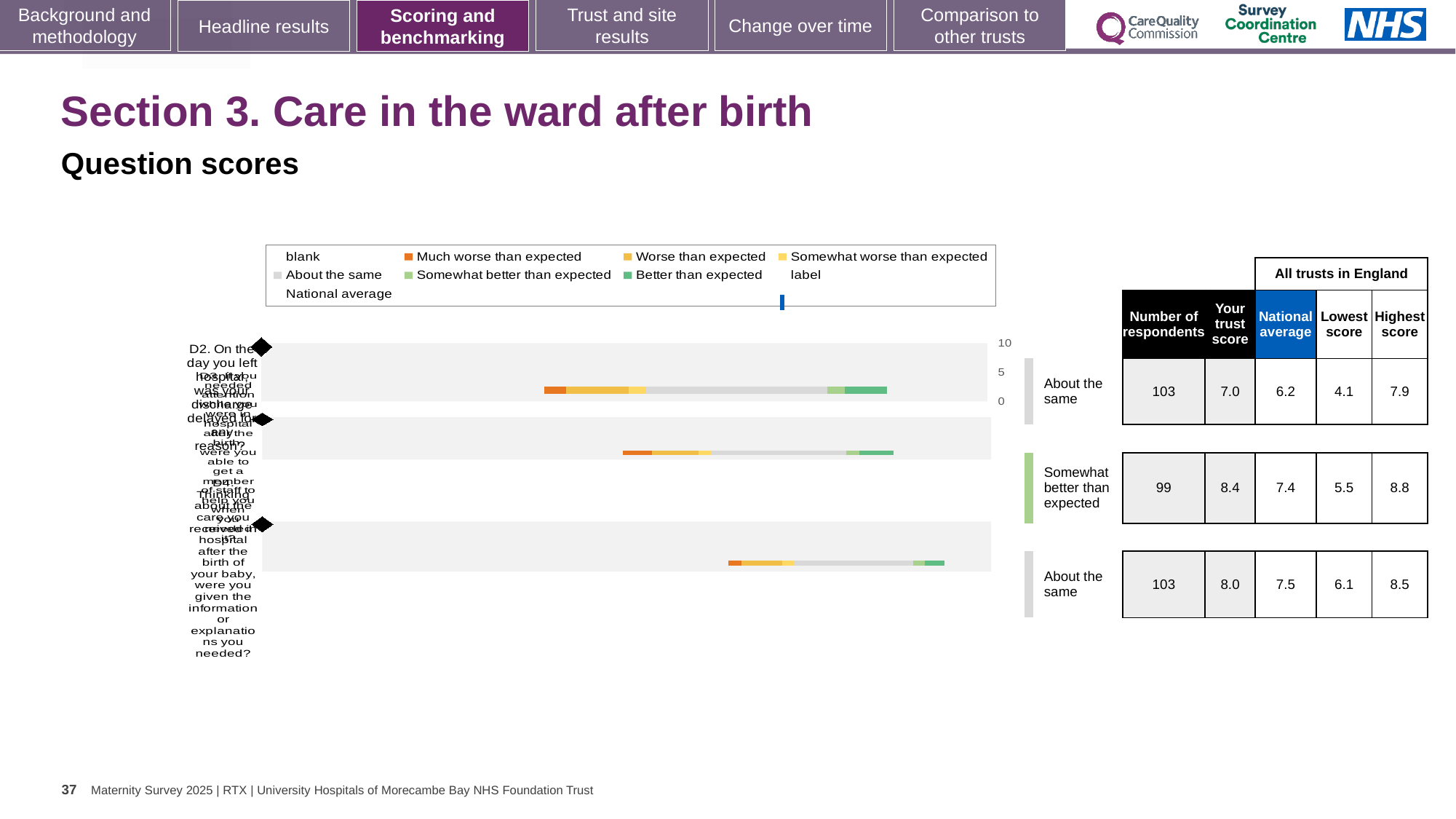
What kind of chart is shown on the slide? bar chart In the table beside the chart, what is the National average for the second row? 7.4 In the table beside the chart, what is the Lowest score for the first row? 4.1 In the table beside the chart, what is the Highest score for the third row? 8.5 In the table beside the chart, is the first row's trust score or its National average larger? trust score (7.0) In the table beside the chart, what is the 'Your trust score' for the first row? 7.0 In the table beside the chart, which row has the lowest National average? the first row (6.2) How many horizontal bars are plotted in the chart? 3 In the table beside the chart, what is the difference between the trust score and the National average in the second row? 1.0 In the table beside the chart, how many respondents are listed for the second row? 99 Which legend entry is shown in orange? Much worse than expected In the table beside the chart, which row has the highest 'Your trust score'? the second row (8.4)